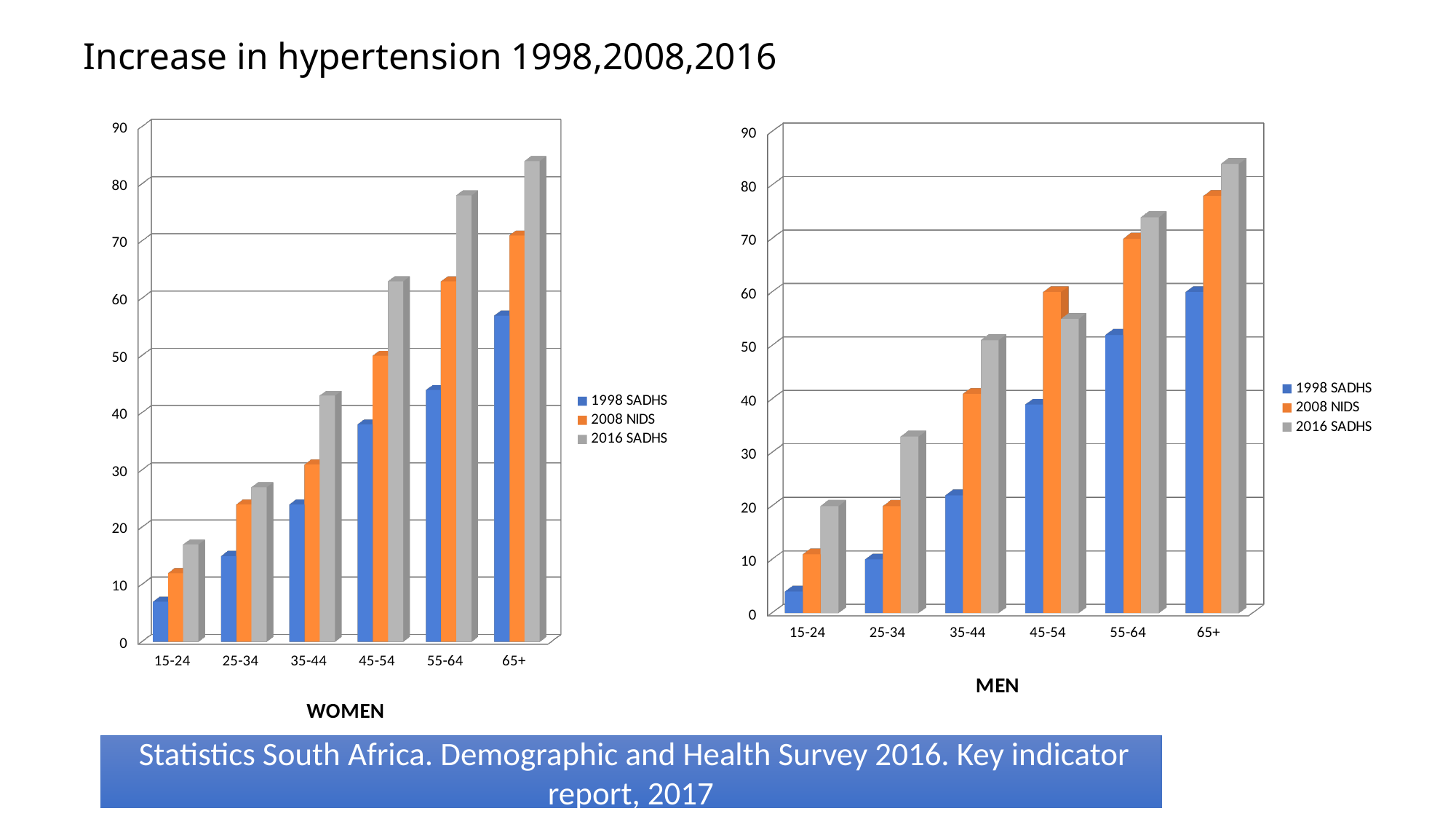
In the WOMEN chart, for the 55-64 age group, which is larger: 1998 SADHS or 2008 NIDS? 2008 NIDS In the MEN chart, for the 45-54 age group, which is larger: 2008 NIDS or 2016 SADHS? 2008 NIDS What kind of chart is the WOMEN chart? bar chart In the WOMEN chart, which age group has the highest 2016 SADHS bar? 65+ In the WOMEN chart, is the 2016 SADHS value for 65+ greater or less than 80? greater In the MEN chart, which age group has the lowest 1998 SADHS bar? 15-24 In the WOMEN chart, do the 1998 SADHS values rise or fall as age group increases along the x axis? rise In the MEN chart, is the 2008 NIDS value for 45-54 greater or less than 50? greater How many series does the legend of the MEN chart list? 3 How many age groups are shown on the x axis of the WOMEN chart? 6 In the MEN chart, what colour represents the 2008 NIDS series? orange In the WOMEN chart, is the 1998 SADHS value for 15-24 greater or less than 10? less